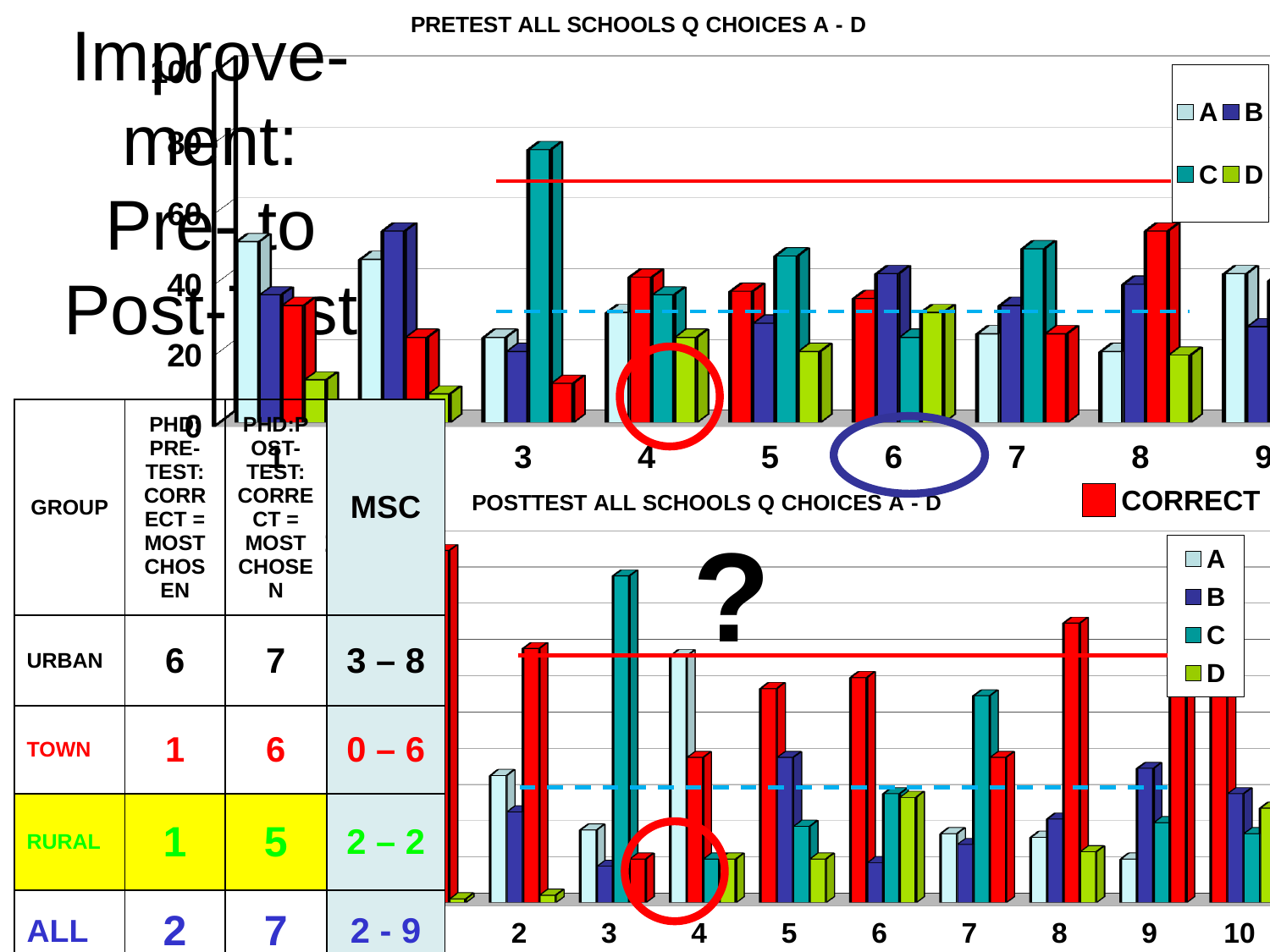
How many series does the legend of the POSTTEST ALL SCHOOLS Q CHOICES A - D chart list? 4 In the PRETEST ALL SCHOOLS Q CHOICES A - D chart, is the value of series C for category 6 greater or less than 40? less In the PRETEST ALL SCHOOLS Q CHOICES A - D chart, which series has the highest value for category 7? C In the PRETEST ALL SCHOOLS Q CHOICES A - D chart, for category 6, is the value of series B larger or the value of series C? B In the PRETEST ALL SCHOOLS Q CHOICES A - D chart, is the value of series C for category 7 greater or less than 40? greater What are the legend entries of the PRETEST ALL SCHOOLS Q CHOICES A - D chart? A, B, C, D What is the title of the top chart on the slide? PRETEST ALL SCHOOLS Q CHOICES A - D In the PRETEST ALL SCHOOLS Q CHOICES A - D chart, which series has the highest value for category 3? C In the PRETEST ALL SCHOOLS Q CHOICES A - D chart, is the value of series C for category 3 greater or less than 60? greater What kind of chart is the PRETEST ALL SCHOOLS Q CHOICES A - D chart? bar chart In the POSTTEST ALL SCHOOLS Q CHOICES A - D chart, which series has the highest value for category 3? C